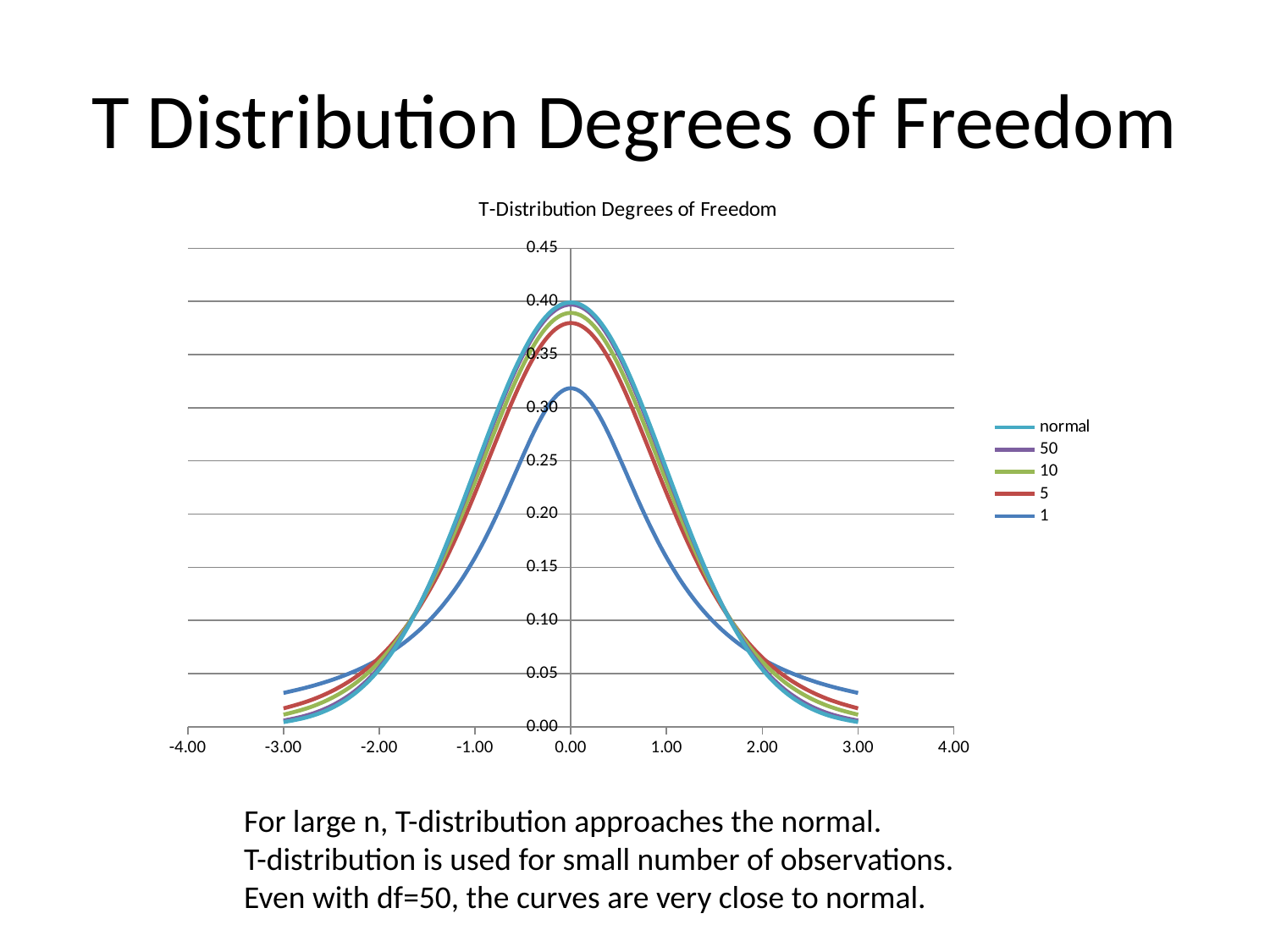
Do the values of the normal series rise or fall as x goes from 0.00 to 3.00? fall At x = 0.00, which is larger: the normal series or the series labelled 1? normal Is the peak value of the normal series greater or less than 0.35? greater What is the title of the chart? T-Distribution Degrees of Freedom Is the peak value of the series labelled 5 greater or less than 0.35? greater Is the peak value of the series labelled 1 greater or less than 0.35? less What kind of chart is shown on the slide? line chart Do the values of the series labelled 1 rise or fall as x goes from -3.00 to 0.00? rise At x = 3.00, which is larger: the series labelled 1 or the normal series? 1 Which series are listed in the legend? normal, 50, 10, 5, 1 Which series has the lowest peak value at x = 0.00? 1 How many series does the legend list? 5